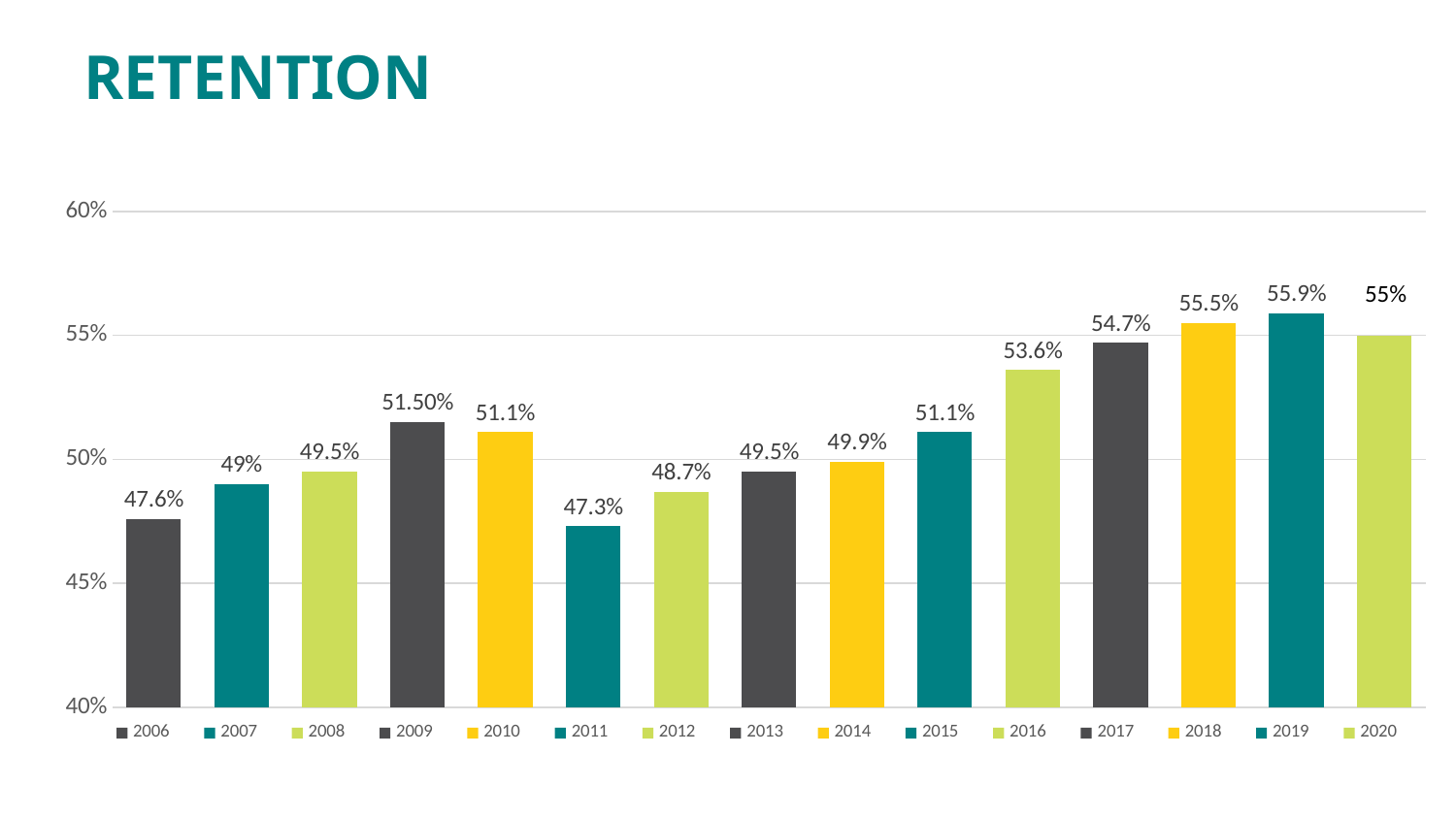
What is the retention value shown for 2011? 47.3% Which year has the lowest retention value? 2011 What is the difference between the retention values for 2020 and 2006? 7.4 percentage points Is the retention value for 2017 greater or less than 50%? greater What is the retention value shown for 2009? 51.50% Which year has the highest retention value? 2019 Which year has a higher retention value, 2016 or 2012? 2016 What kind of chart is shown on the slide? Bar chart What is the retention value shown for 2020? 55% What is the retention value shown for 2019? 55.9% How many bars are plotted in the chart? 15 What is the difference between the retention values for 2019 and 2011? 8.6 percentage points